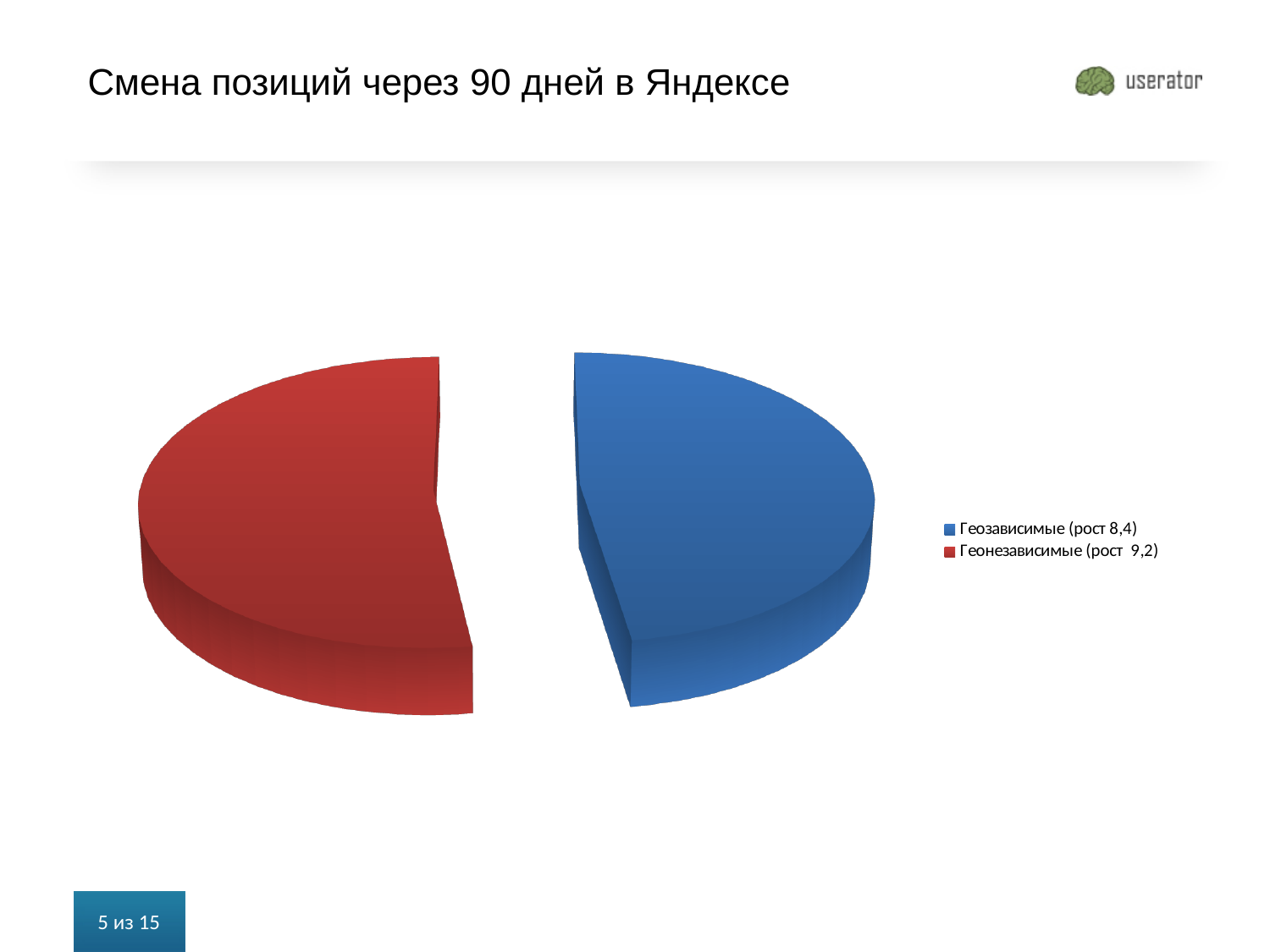
What growth value is given in the legend for Геонезависимые? 9,2 Which category has the lower growth value according to the legend? Геозависимые How many entries does the legend list? 2 What growth value is given in the legend for Геозависимые? 8,4 Which category has the higher growth value according to the legend? Геонезависимые What is the title of the slide's chart? Смена позиций через 90 дней в Яндексе What colour is the slice for Геозависимые? blue Which slice is larger, Геозависимые or Геонезависимые? Геонезависимые What is the difference between the growth values of Геонезависимые and Геозависимые? 0,8 What kind of chart is shown on the slide? pie chart How many slices does the pie chart have? 2